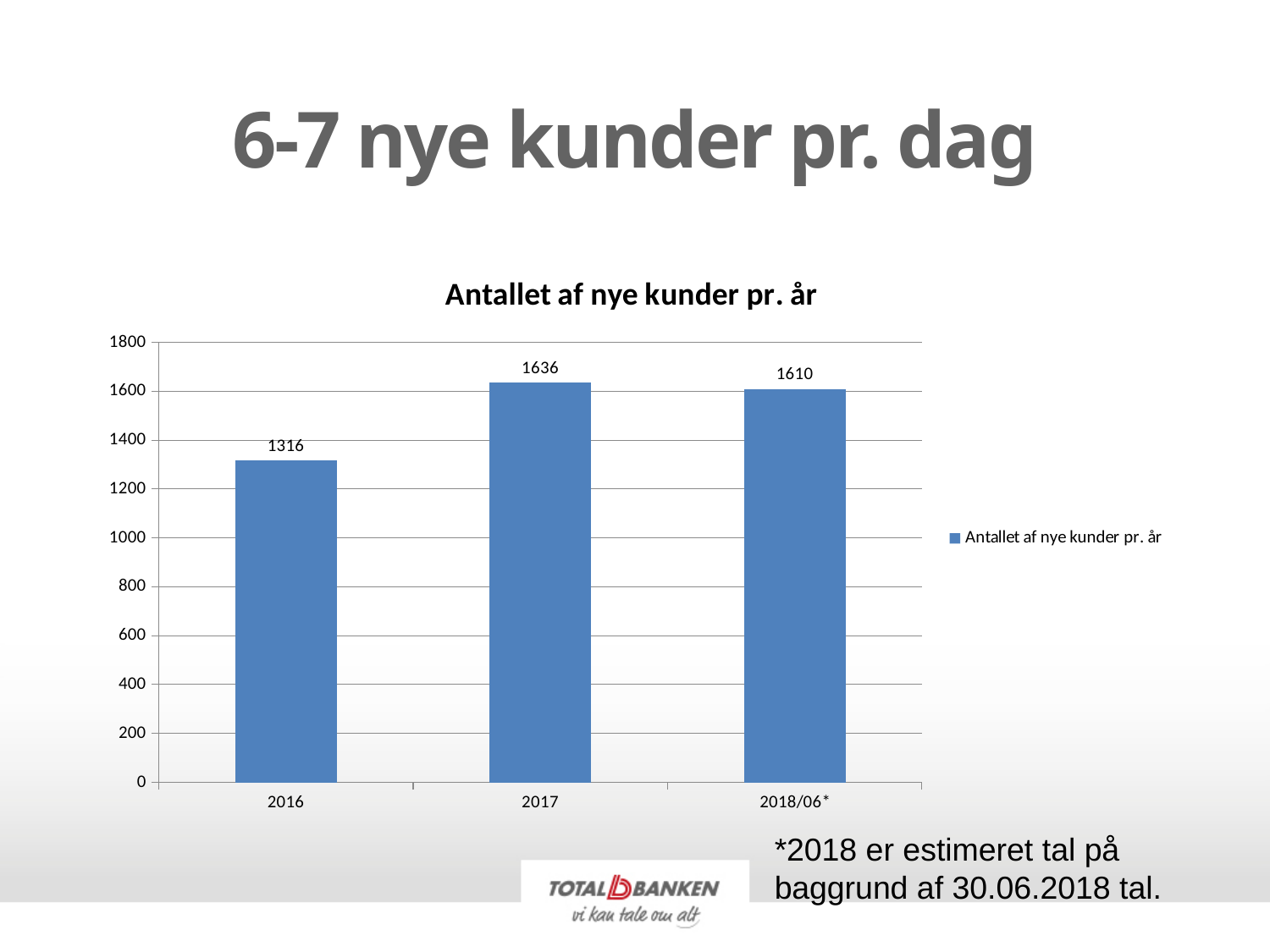
What is the value for 2016? 1316 Which is larger, the value for 2016 or the value for 2018/06*? 2018/06* What kind of chart is shown? bar chart Which category has the highest value? 2017 What is the difference between the values for 2017 and 2018/06*? 26 What is the title of the chart? Antallet af nye kunder pr. år What is the difference between the values for 2017 and 2016? 320 Which category has the lowest value? 2016 What is the value for 2017? 1636 Is the value for 2016 greater or less than 1400? less How many categories are shown on the x axis? 3 What is the value for 2018/06*? 1610